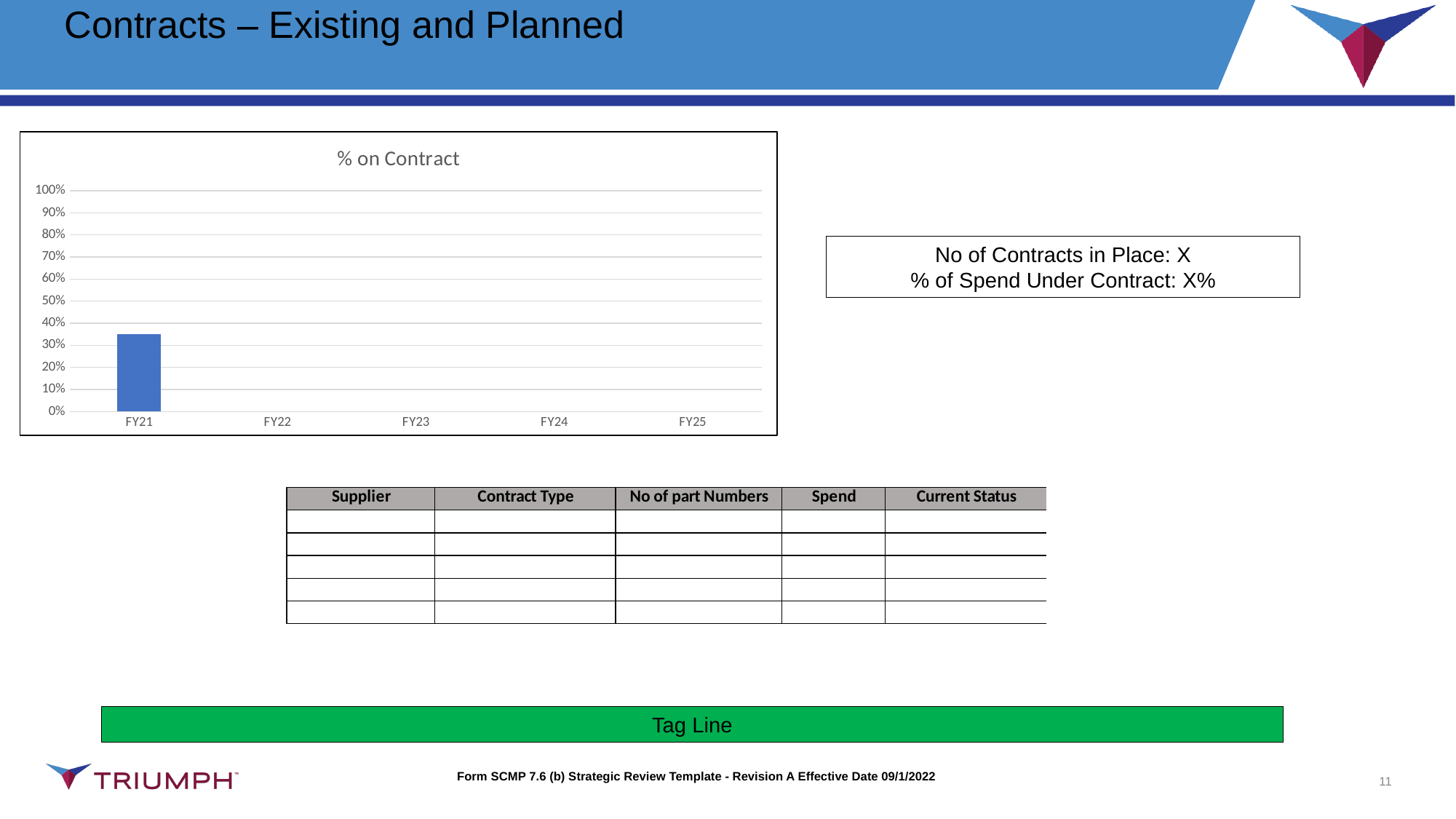
What is the highest value shown on the y axis of the chart? 100% How many fiscal year categories are shown on the x axis of the chart? 5 What is the title of the chart? % on Contract Which fiscal year is the first category on the x axis? FY21 Is the value for FY21 greater or less than 50%? less Is the value for FY21 greater or less than 40%? less What kind of chart is shown on the slide? bar chart Is the value for FY21 greater or less than 30%? greater Which fiscal year is the last category on the x axis? FY25 Which fiscal year has the highest value in the % on Contract chart? FY21